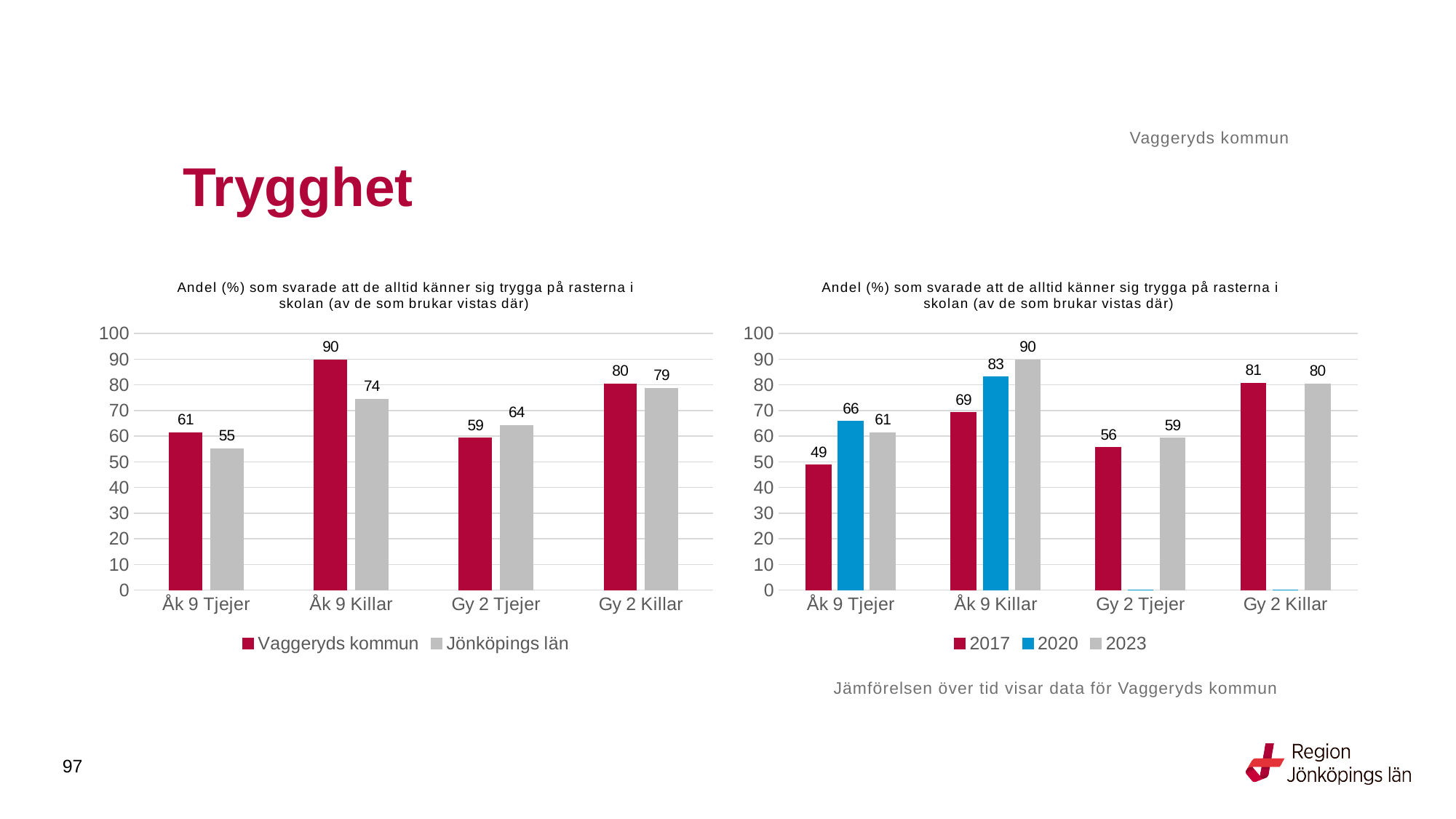
In the right chart, what is the value for 2020 for Åk 9 Killar? 83 What kind of chart is the left chart? Bar chart In the left chart, which category has the lowest value for Vaggeryds kommun? Gy 2 Tjejer In the left chart, which is larger for Gy 2 Tjejer: Vaggeryds kommun or Jönköpings län? Jönköpings län In the left chart, what is the value for Vaggeryds kommun for Åk 9 Killar? 90 How many series does the legend of the right chart list? 3 In the right chart, what is the value for 2017 for Åk 9 Tjejer? 49 In the right chart, what is the difference between the 2023 and 2017 values for Åk 9 Tjejer? 12 In the left chart, what is the value for Jönköpings län for Åk 9 Tjejer? 55 In the right chart, which category has the highest value for 2023? Åk 9 Killar In the left chart, what is the difference between Vaggeryds kommun and Jönköpings län for Åk 9 Killar? 16 How many categories are shown on the x axis of the left chart? 4